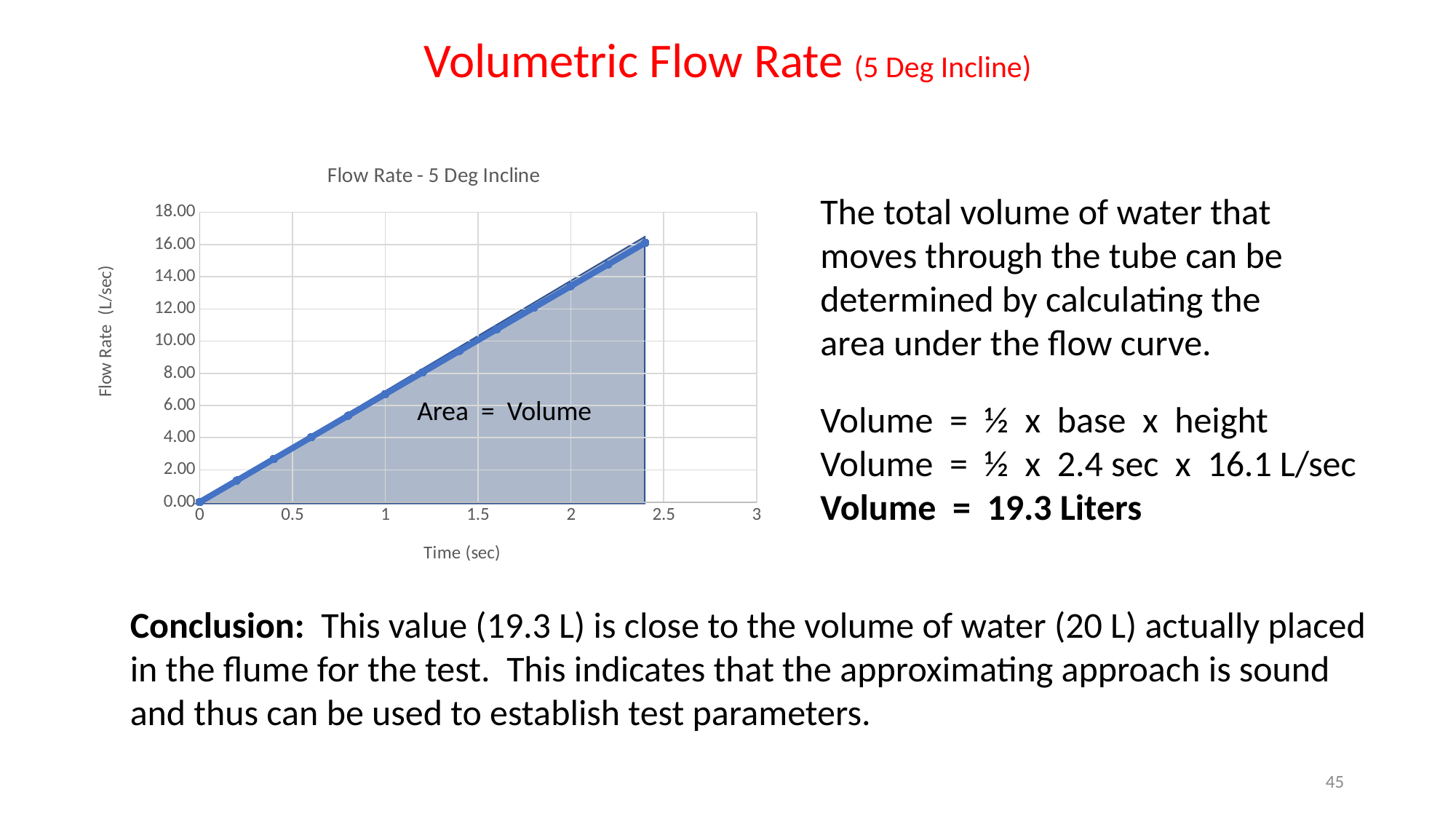
Is the flow rate at 2.4 sec greater or less than 14.00 L/sec? greater At what time is the flow rate lowest on the chart? 0 sec Is the flow rate at 0.5 sec greater or less than 2.00 L/sec? greater Which is larger, the flow rate at 1.5 sec or the flow rate at 0.5 sec? 1.5 sec What kind of chart is shown on the slide? line chart What is the label of the x axis of the chart? Time (sec) What is the title of the chart? Flow Rate - 5 Deg Incline Is the flow rate at 1 sec greater or less than 8.00 L/sec? less At what time does the flow rate reach its highest value on the chart? 2.4 sec Does the flow rate rise or fall as time increases along the x axis? rises What is the flow rate at time 0 on the chart? 0.00